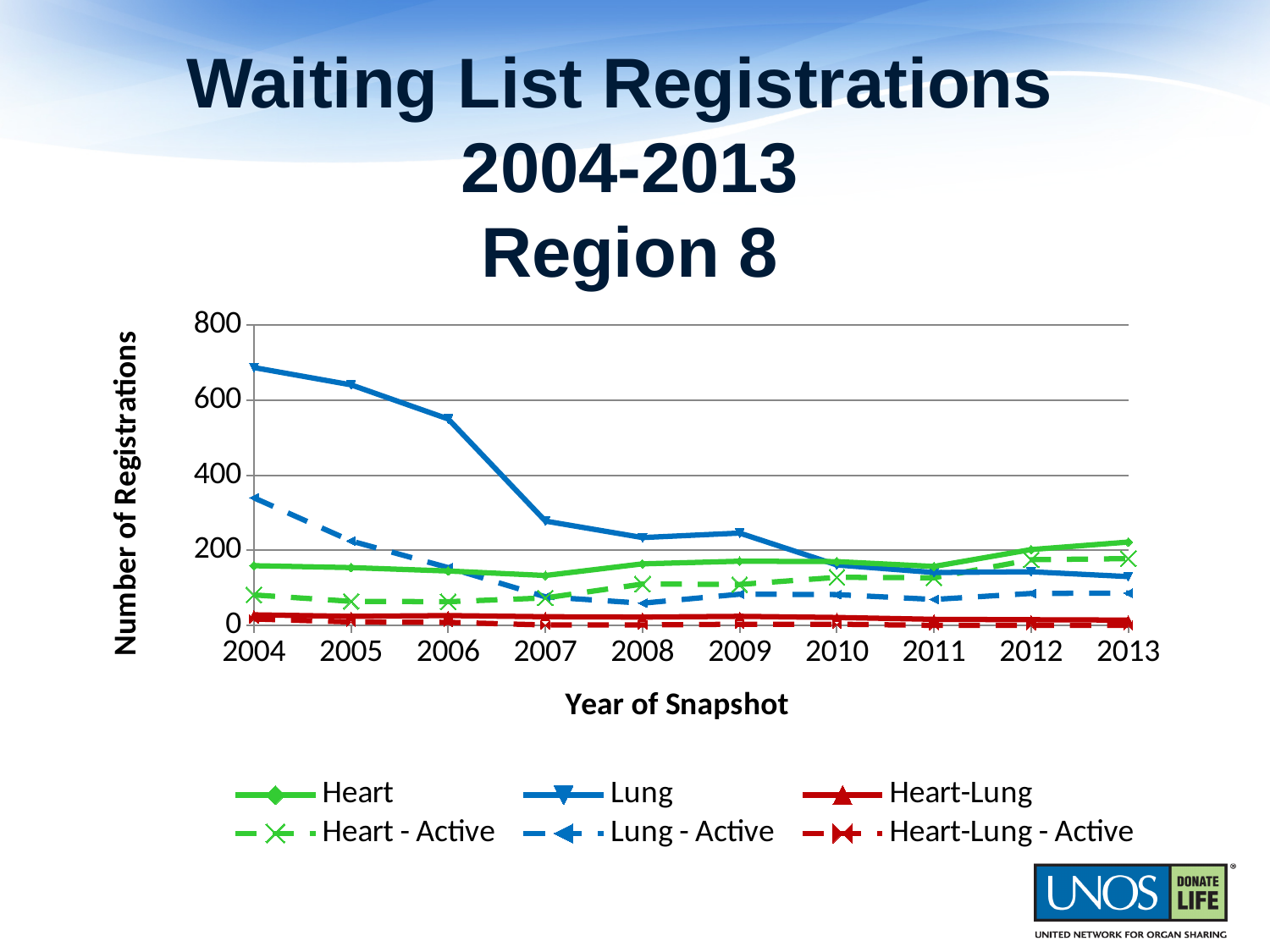
Which is larger in 2004, the Heart value or the Lung value? Lung How many series does the legend list? 6 How many years are plotted along the x axis? 10 Is the value for Lung - Active in 2004 greater or less than 400? less Is the value for Lung in 2006 greater or less than 600? less Is the value for Lung in 2004 greater or less than 600? greater Does the Lung series rise or fall from 2004 to 2013? fall Which is larger in 2013, the Heart value or the Lung value? Heart What kind of chart is shown on the slide? line chart In which year is the Lung series at its highest? 2004 What is the label of the y axis? Number of Registrations